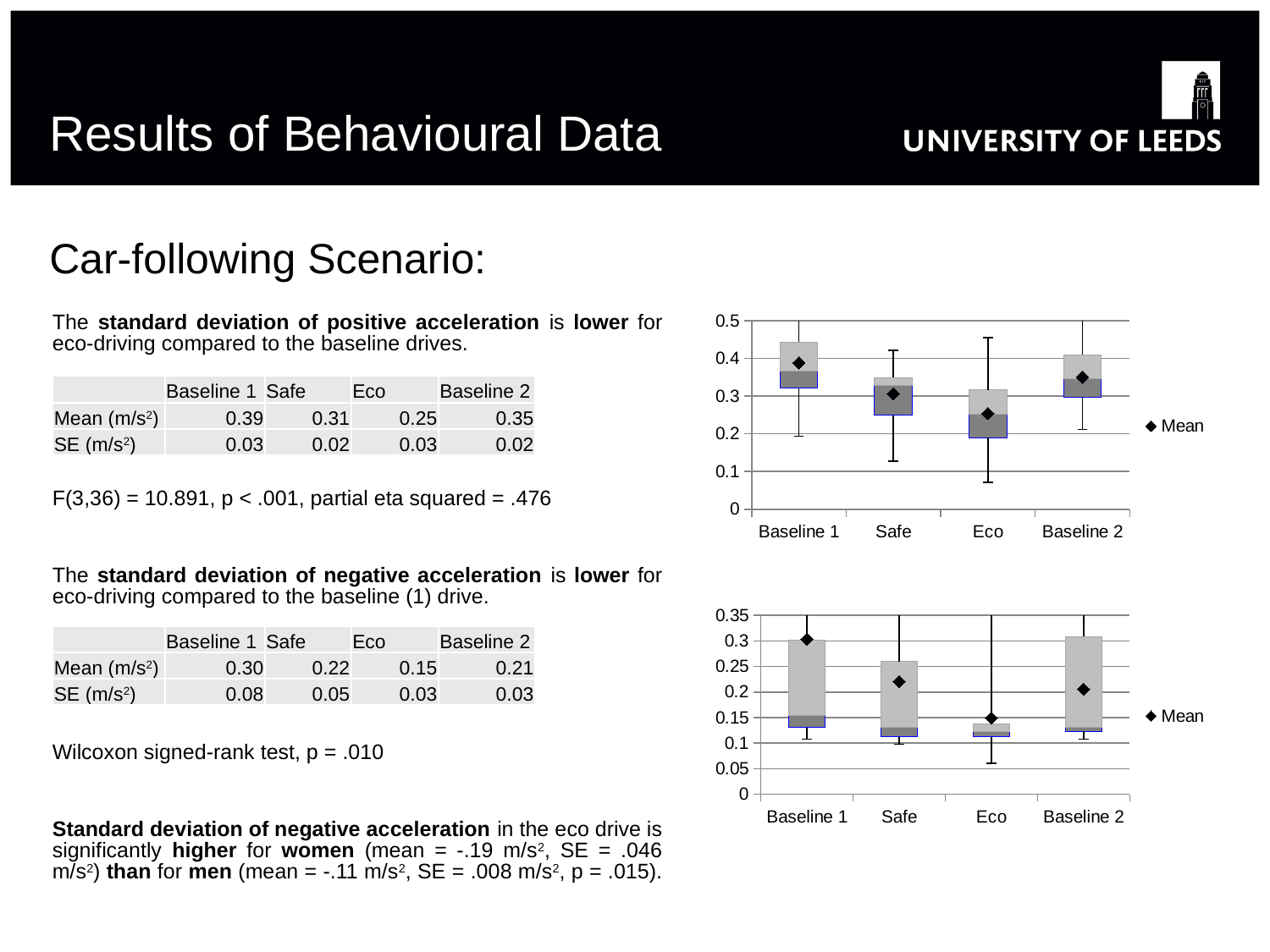
In the bottom chart, which category has the lowest mean marker? Eco In the bottom chart, is the mean value for Eco greater or less than 0.2? less In the bottom chart, is the mean value for Baseline 1 greater or less than 0.25? greater What kind of chart is the top chart on the slide? Box plot How many categories are shown on the x axis of the top chart? 4 In the top chart, which category has the lowest mean marker? Eco In the bottom chart, which category has the highest mean marker? Baseline 1 What is the label of the legend entry shown next to the top chart? Mean How many entries does the legend of the bottom chart list? 1 In the top chart, is the mean value for Baseline 2 greater or less than 0.3? greater In the top chart, which category has the highest mean marker? Baseline 1